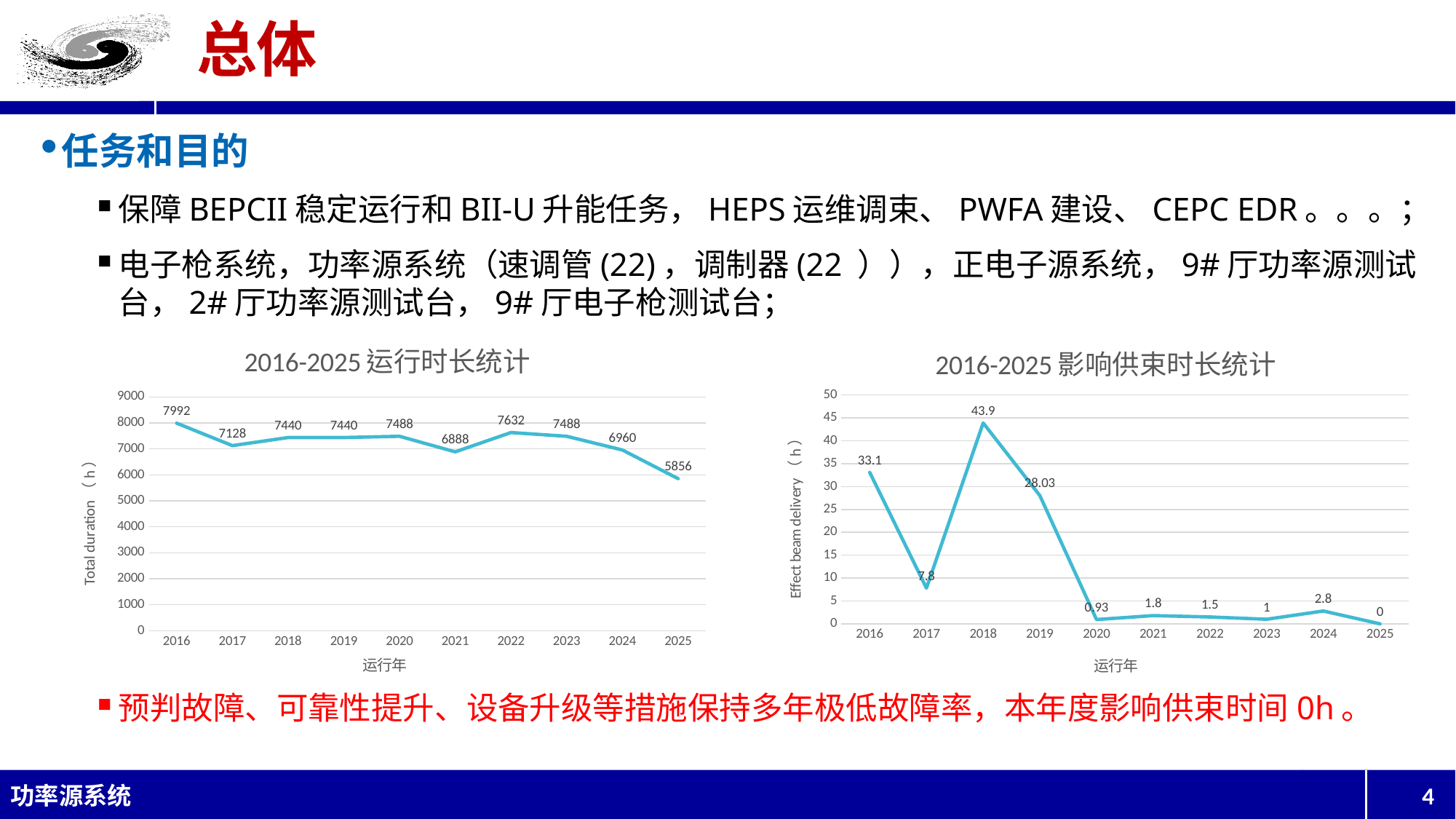
In the chart titled 2016-2025 影响供束时长统计, what is the value for 2018? 43.9 In the chart titled 2016-2025 运行时长统计, how many years are plotted? 10 In the chart titled 2016-2025 影响供束时长统计, which is larger, the value for 2016 or the value for 2017? 2016 In the chart titled 2016-2025 影响供束时长统计, what is the value for 2019? 28.03 In the chart titled 2016-2025 运行时长统计, which year has the highest value? 2016 In the chart titled 2016-2025 运行时长统计, which year has the lowest value? 2025 What kind of chart is the chart titled 2016-2025 运行时长统计? line chart In the chart titled 2016-2025 运行时长统计, what is the value for 2025? 5856 In the chart titled 2016-2025 运行时长统计, what is the value for 2016? 7992 In the chart titled 2016-2025 影响供束时长统计, which year has the highest value? 2018 What is the y-axis label of the chart titled 2016-2025 影响供束时长统计? Effect beam delivery（h） In the chart titled 2016-2025 运行时长统计, what is the difference between the values for 2016 and 2017? 864